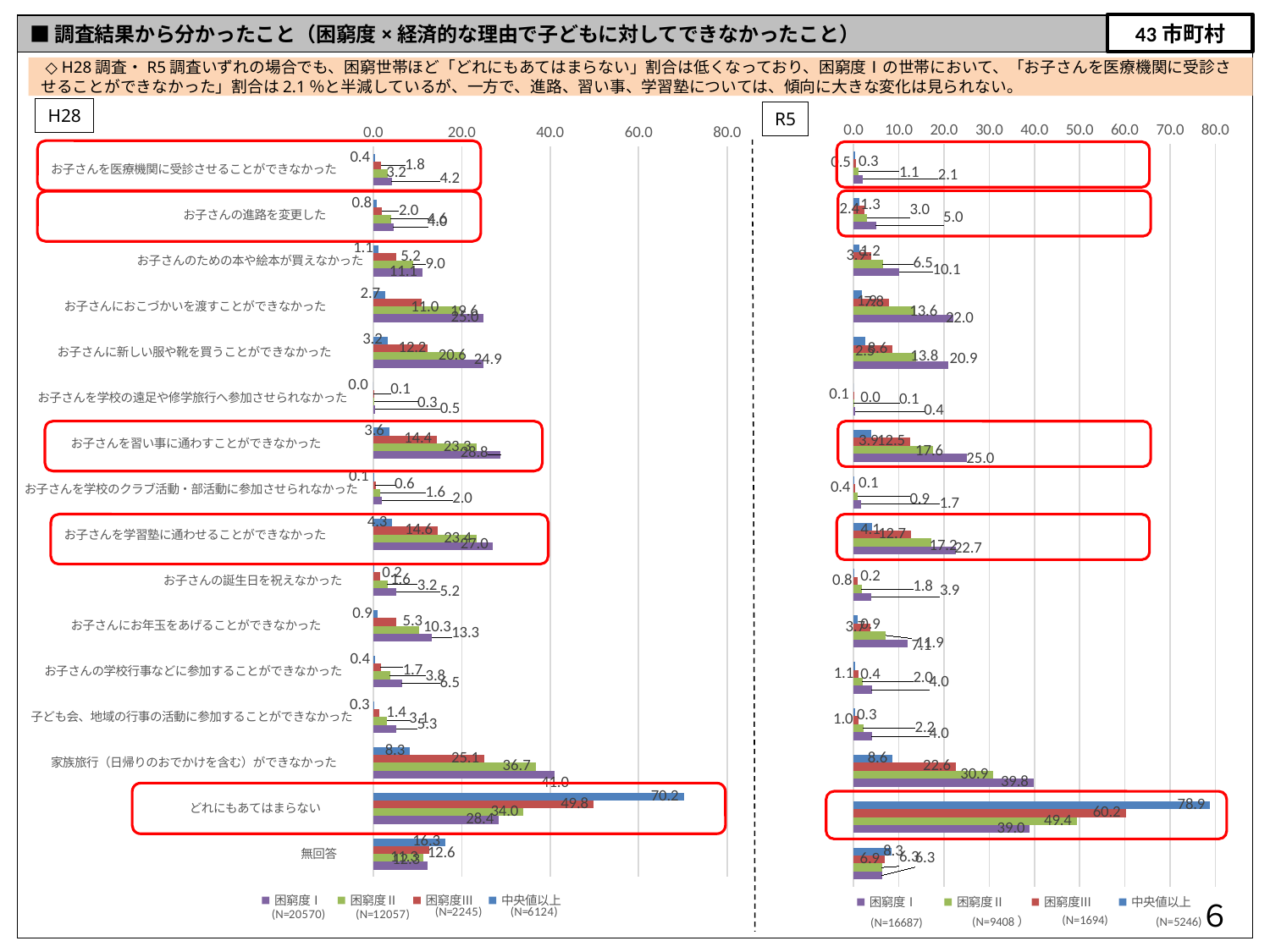
In the H28 chart, what is the difference between the 困窮度Ⅰ value (4.2) and the 中央値以上 value (0.4) for お子さんを医療機関に受診させることができなかった? 3.8 In the R5 chart, is the 困窮度Ⅲ value for どれにもあてはまらない greater or less than 50.0? greater In the R5 chart, what is the difference between the 中央値以上 value (78.9) and the 困窮度Ⅰ value (39.0) for どれにもあてはまらない? 39.9 What type of chart is used for the H28 chart on the left? Bar chart In the R5 chart, what is the value for 困窮度Ⅰ in the category どれにもあてはまらない? 39.0 In the R5 chart, what is the value for 困窮度Ⅰ in the category お子さんを医療機関に受診させることができなかった? 2.1 In the H28 chart, which category has the highest value for 中央値以上? どれにもあてはまらない In the H28 chart, which has the larger 困窮度Ⅲ value: 家族旅行（日帰りのおでかけを含む）ができなかった or お子さんを習い事に通わすことができなかった? 家族旅行（日帰りのおでかけを含む）ができなかった In the H28 chart, what is the value for 困窮度Ⅰ in the category お子さんにお年玉をあげることができなかった? 13.3 How many categories are plotted in the H28 chart? 16 In the H28 chart, what is the value for 中央値以上 in the category どれにもあてはまらない? 70.2 How many series does the legend of the R5 chart list? 4